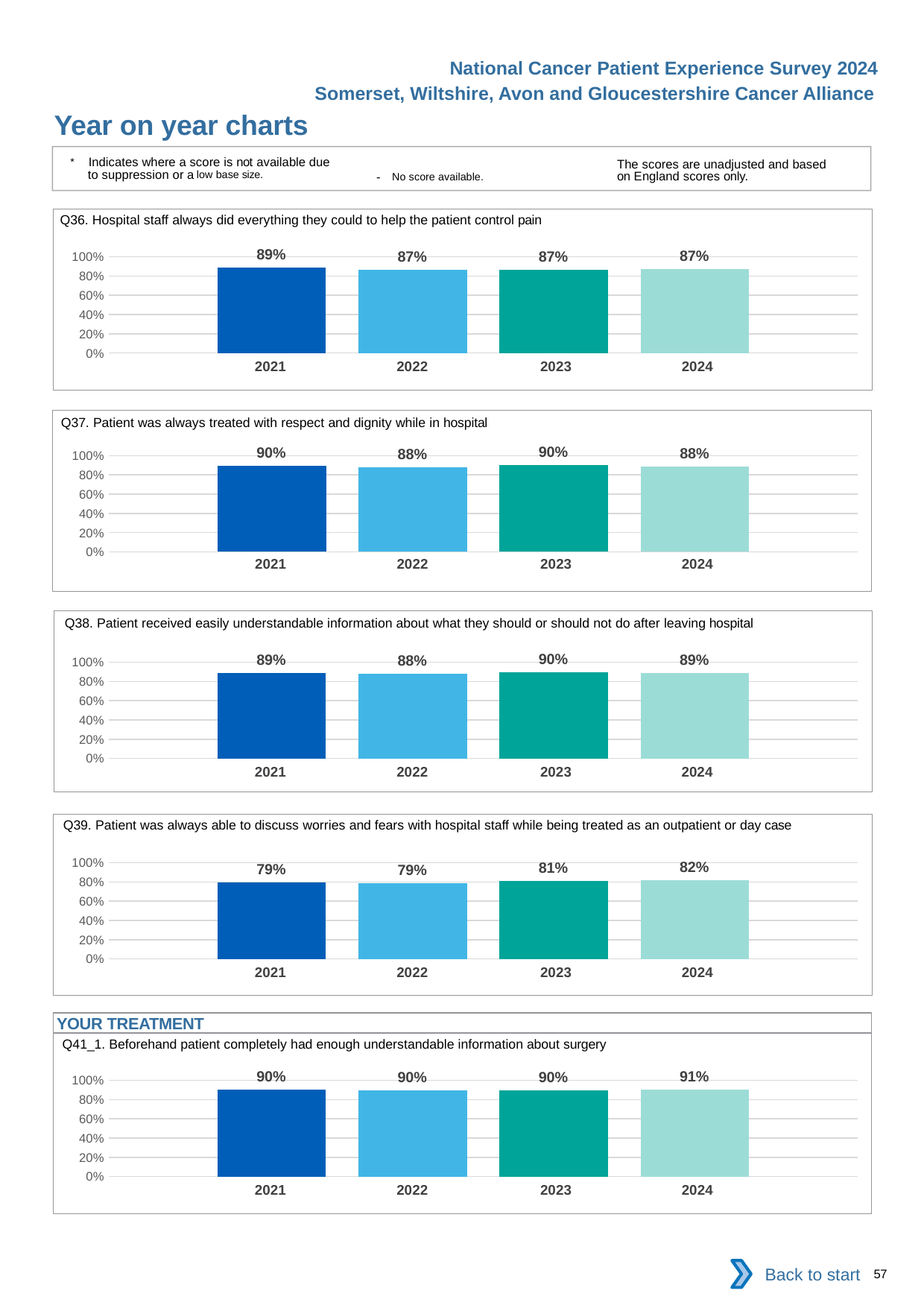
In the Q36 chart, is the value for 2022 larger or smaller than the value for 2021? smaller In the Q37 chart (patient was always treated with respect and dignity while in hospital), what is the value for 2022? 88% In the Q38 chart (patient received easily understandable information about what they should or should not do after leaving hospital), which year has the highest value? 2023 In the Q39 chart (patient was always able to discuss worries and fears with hospital staff while being treated as an outpatient or day case), what is the value for 2024? 82% How many charts are shown on the slide? 5 In the Q39 chart, what is the difference between the 2024 value and the 2021 value? 3% In the Q41_1 chart (beforehand patient completely had enough understandable information about surgery), which year has the highest value? 2024 In the Q41_1 chart, what is the difference between the 2024 value and the 2023 value? 1% How many years (bars) are shown in the Q37 chart? 4 In the Q39 chart, do the values generally rise or fall from 2021 to 2024? rise In the Q36 chart (hospital staff always did everything they could to help the patient control pain), what is the value for 2021? 89% What kind of chart is the Q38 chart? bar chart